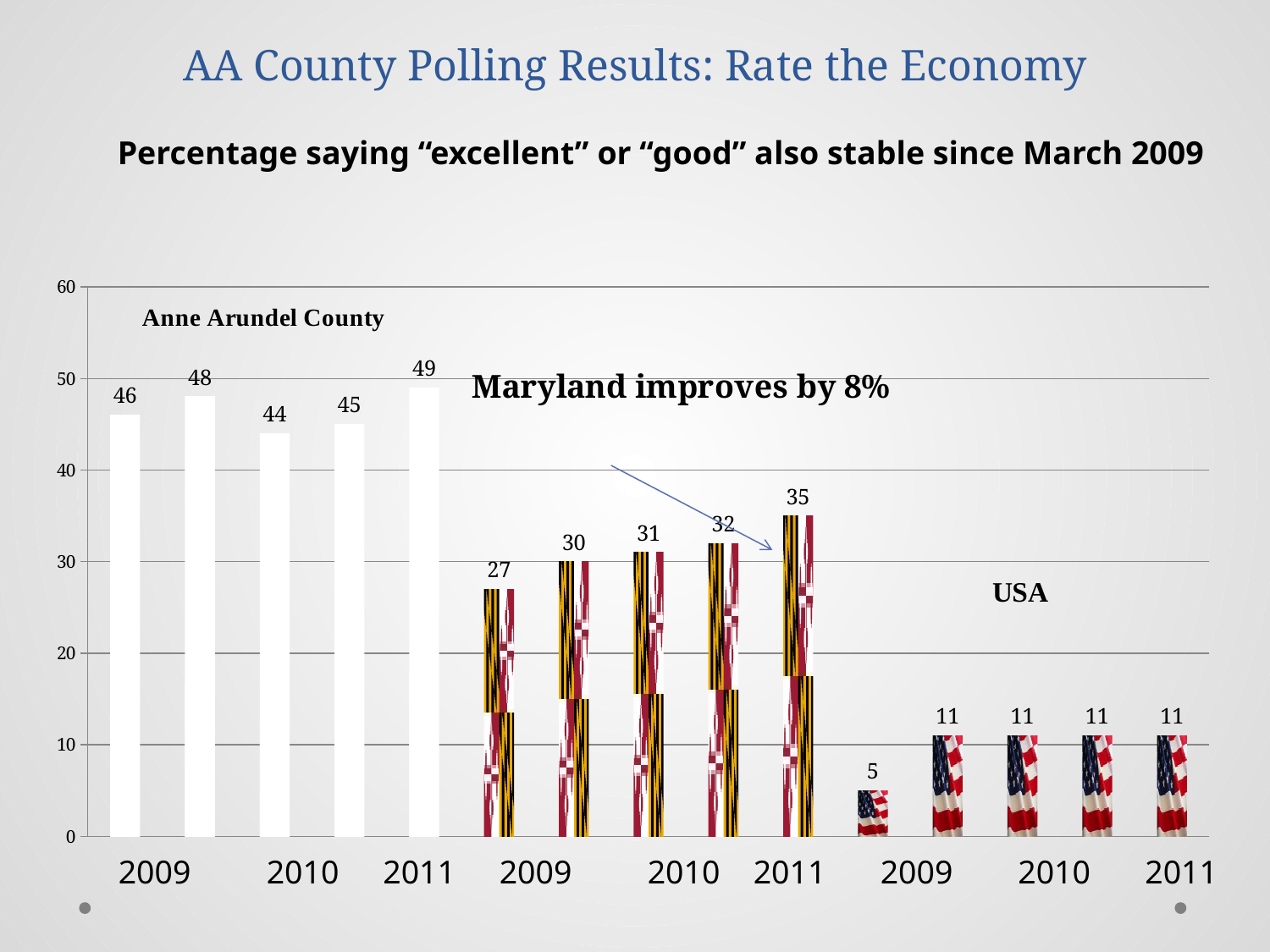
What is the value of the leftmost (first 2009) bar in the Anne Arundel County group? 46 Which group has the highest single bar on the chart? Anne Arundel County What is the difference between the Maryland 2011 bar (35) and the first Maryland 2009 bar (27)? 8 What is the value of the 2011 bar for Maryland? 35 Do the Maryland bars rise or fall from the first 2009 bar to the 2011 bar? rise What does the annotation with the arrow pointing to the Maryland bars say? Maryland improves by 8% What is the value of the 2011 bar for Anne Arundel County? 49 Which is larger, the 2011 bar for Anne Arundel County or the 2011 bar for Maryland? Anne Arundel County What is the value of the leftmost (first 2009) bar in the USA group? 5 How many bars are plotted on the chart in total? 15 What kind of chart is shown on the slide? bar chart What is the lowest value shown on the chart? 5